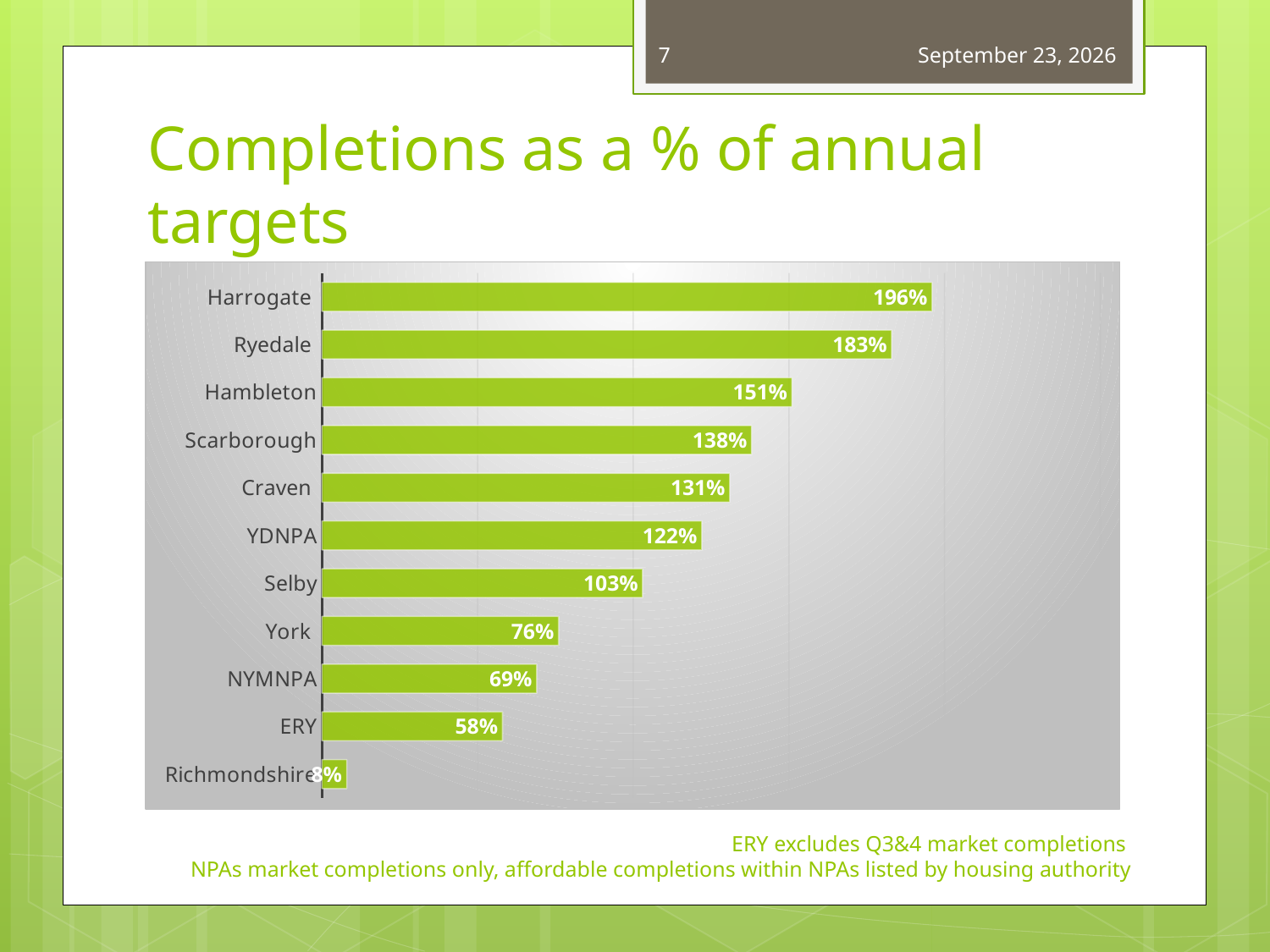
What kind of chart is shown on the slide? Bar chart What is the value for Harrogate? 196% What is the difference between the values for Selby and York? 27% Which category has the lowest value? Richmondshire Which is larger, the value for Craven or the value for YDNPA? Craven How many categories are shown in the chart? 11 What is the value for Richmondshire? 8% What is the value for Scarborough? 138% What is the title of the slide containing the chart? Completions as a % of annual targets What is the difference between the values for Harrogate and Ryedale? 13% Which category has the highest value? Harrogate What is the value for NYMNPA? 69%